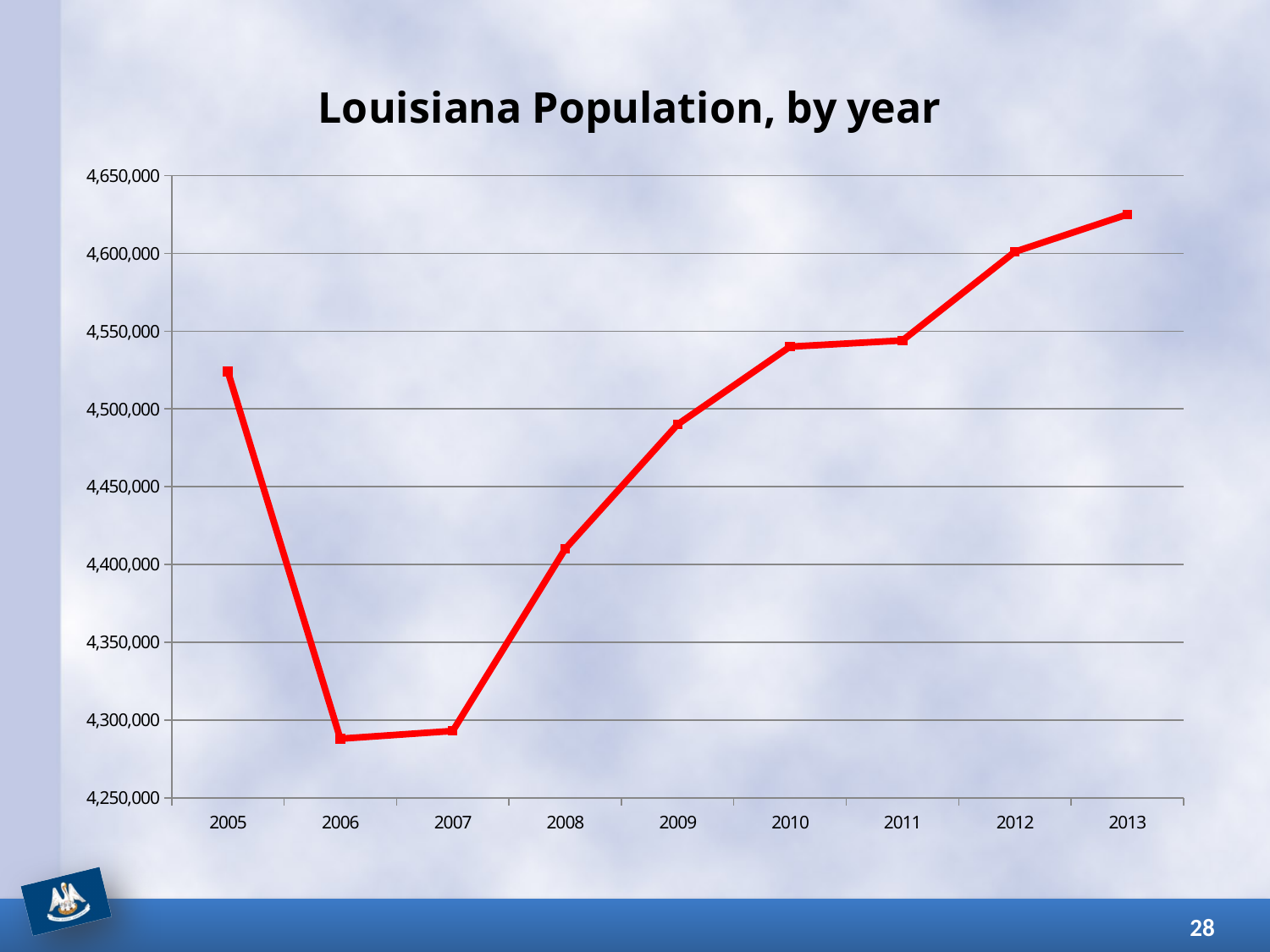
Which year has the highest population value? 2013 Which is larger, the value for 2005 or the value for 2008? 2005 Is the value for 2005 greater or less than 4,500,000? greater Is the value for 2008 greater or less than 4,400,000? greater What is the title of the chart? Louisiana Population, by year Do the values rise or fall from 2007 to 2013? rise Is the value for 2013 greater or less than 4,600,000? greater How many years are plotted on the x axis? 9 Which is larger, the value for 2009 or the value for 2012? 2012 What type of chart is shown on the slide? Line chart